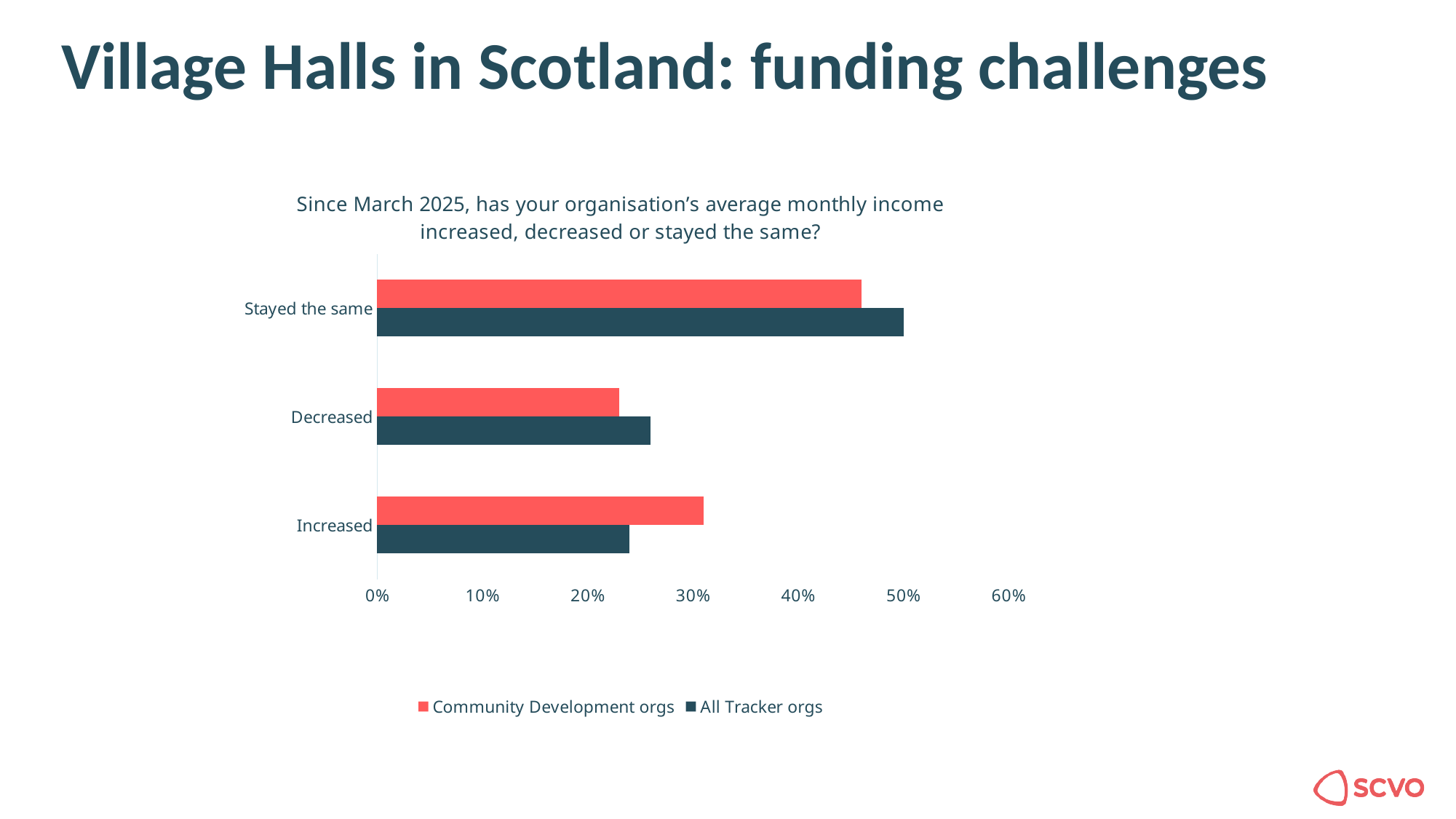
Which category has the highest value for Community Development orgs? Stayed the same For 'Increased', which series has the larger value: Community Development orgs or All Tracker orgs? Community Development orgs How many response categories are shown on the chart? 3 Which series is shown in red in the legend? Community Development orgs For 'Stayed the same', which series has the larger value: Community Development orgs or All Tracker orgs? All Tracker orgs Which category has the lowest value for Community Development orgs? Decreased Is the value for Community Development orgs in 'Decreased' greater or less than 30%? less Which category has the highest value for All Tracker orgs? Stayed the same How many series does the legend list? 2 Is the value for Community Development orgs in 'Stayed the same' greater or less than 40%? greater Is the value for All Tracker orgs in 'Increased' greater or less than 30%? less What kind of chart is shown on the slide? Bar chart